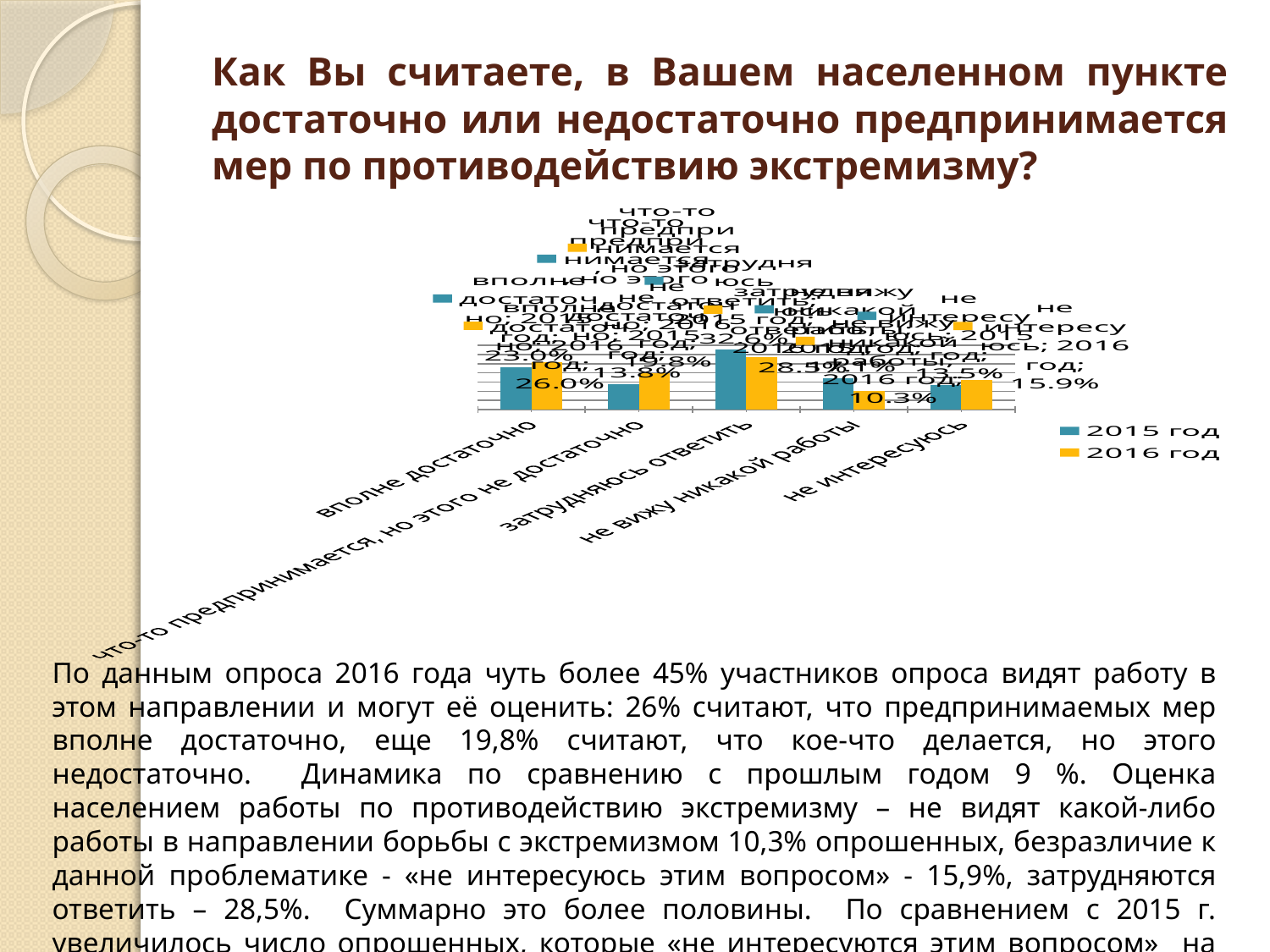
Which category has the lowest value in the 2016 год series? не вижу никакой работы What kind of chart is shown on the slide? bar chart What is the difference between the 2016 год and 2015 год values for "вполне достаточно"? 3.0% What is the value for "затрудняюсь ответить" in the 2015 год series? 32.6% How many categories are shown on the x axis of the chart? 5 Which category has the highest value in the 2016 год series? затрудняюсь ответить What is the value for "затрудняюсь ответить" in the 2016 год series? 28.5% How many series does the chart legend list? 2 What is the value for "вполне достаточно" in the 2016 год series? 26.0% For "затрудняюсь ответить", which series has the larger value, 2015 год or 2016 год? 2015 год What is the value for "вполне достаточно" in the 2015 год series? 23.0% What is the value for "не интересуюсь" in the 2016 год series? 15.9%